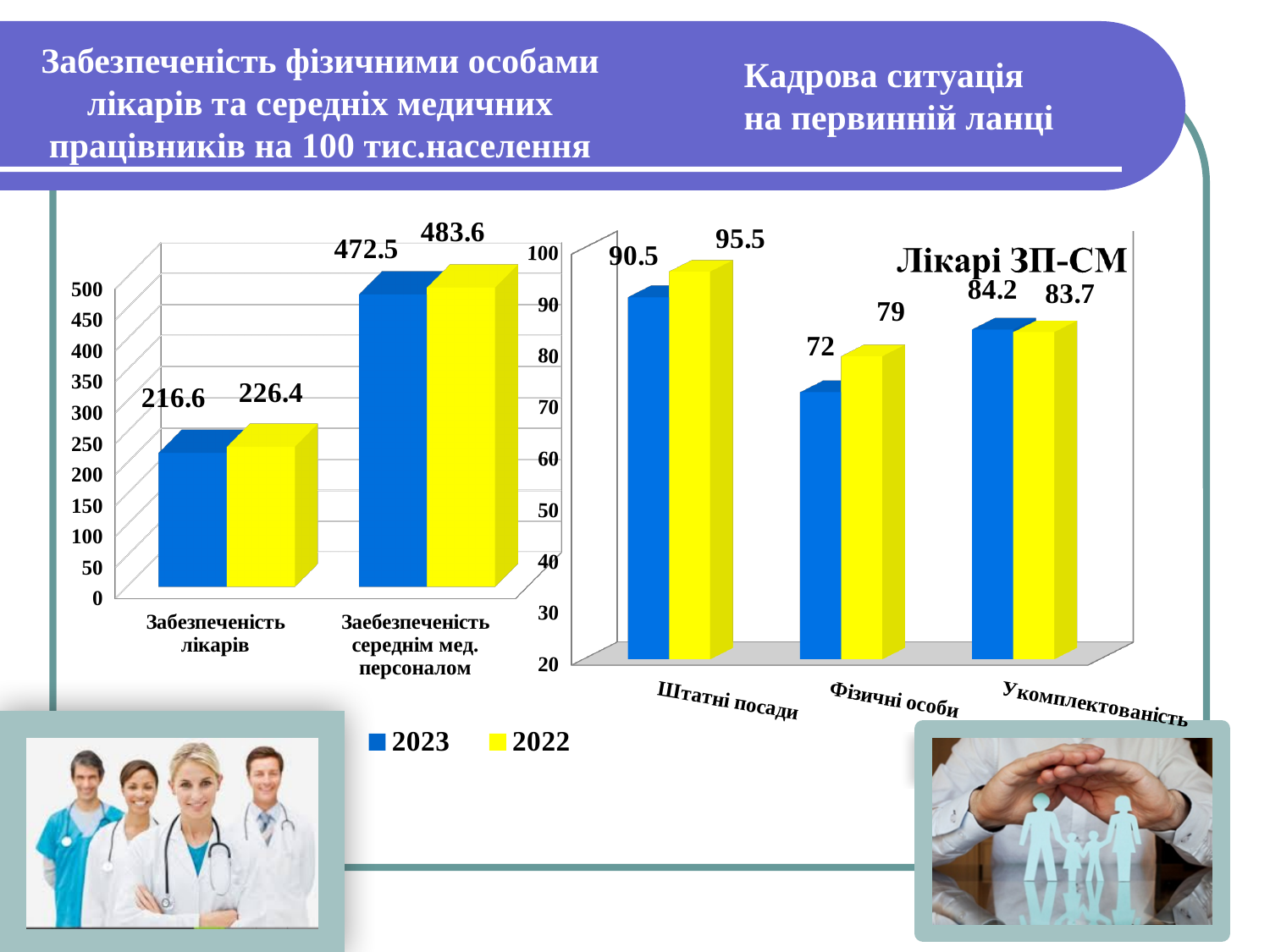
In the right chart (Лікарі ЗП-СМ), which category has the highest 2022 value? Штатні посади How many series does the legend list? 2 In the right chart (Лікарі ЗП-СМ), what is the 2023 value for Фізичні особи? 72 In the left chart, what is the difference between the 2022 and 2023 values for Забезпеченість лікарів? 9.8 In the left chart, how many categories are shown on the x axis? 2 In the right chart (Лікарі ЗП-СМ), what is the difference between the 2022 and 2023 values for Фізичні особи? 7 In the left chart, which is larger for Заебезпеченість середнім мед. персоналом: the 2023 value or the 2022 value? 2022 In the left chart, what is the 2022 value for Заебезпеченість середнім мед. персоналом? 483.6 In the left chart (Забезпеченість фізичними особами лікарів та середніх медичних працівників на 100 тис.населення), what is the 2023 value for Забезпеченість лікарів? 216.6 In the right chart (Лікарі ЗП-СМ), what is the 2022 value for Штатні посади? 95.5 In the right chart (Лікарі ЗП-СМ), which category has the lowest 2023 value? Фізичні особи What kind of chart is the right chart (Лікарі ЗП-СМ)? Bar chart